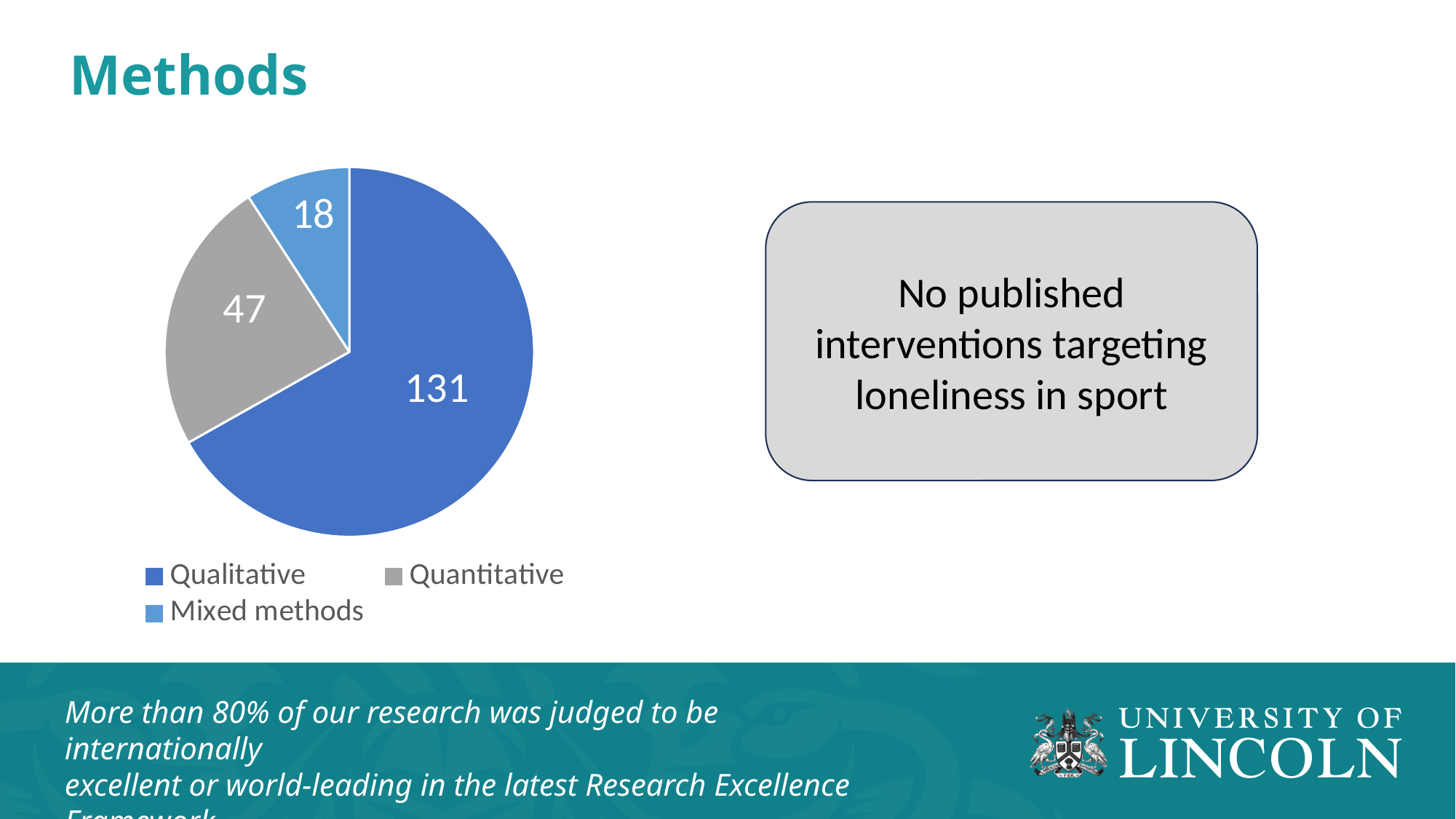
What colour is the Quantitative slice in the pie chart? Grey Which category has the largest slice in the pie chart? Qualitative What is the value for Quantitative in the pie chart? 47 What is the value for Qualitative in the pie chart? 131 What is the total of all slices in the pie chart? 196 Which category has the smallest slice in the pie chart? Mixed methods What is the difference between the Qualitative and Quantitative values? 84 What is the difference between the Quantitative and Mixed methods values? 29 Which is larger, Quantitative or Mixed methods? Quantitative What is the value for Mixed methods in the pie chart? 18 How many categories does the pie chart show? 3 What type of chart is shown on the slide? Pie chart